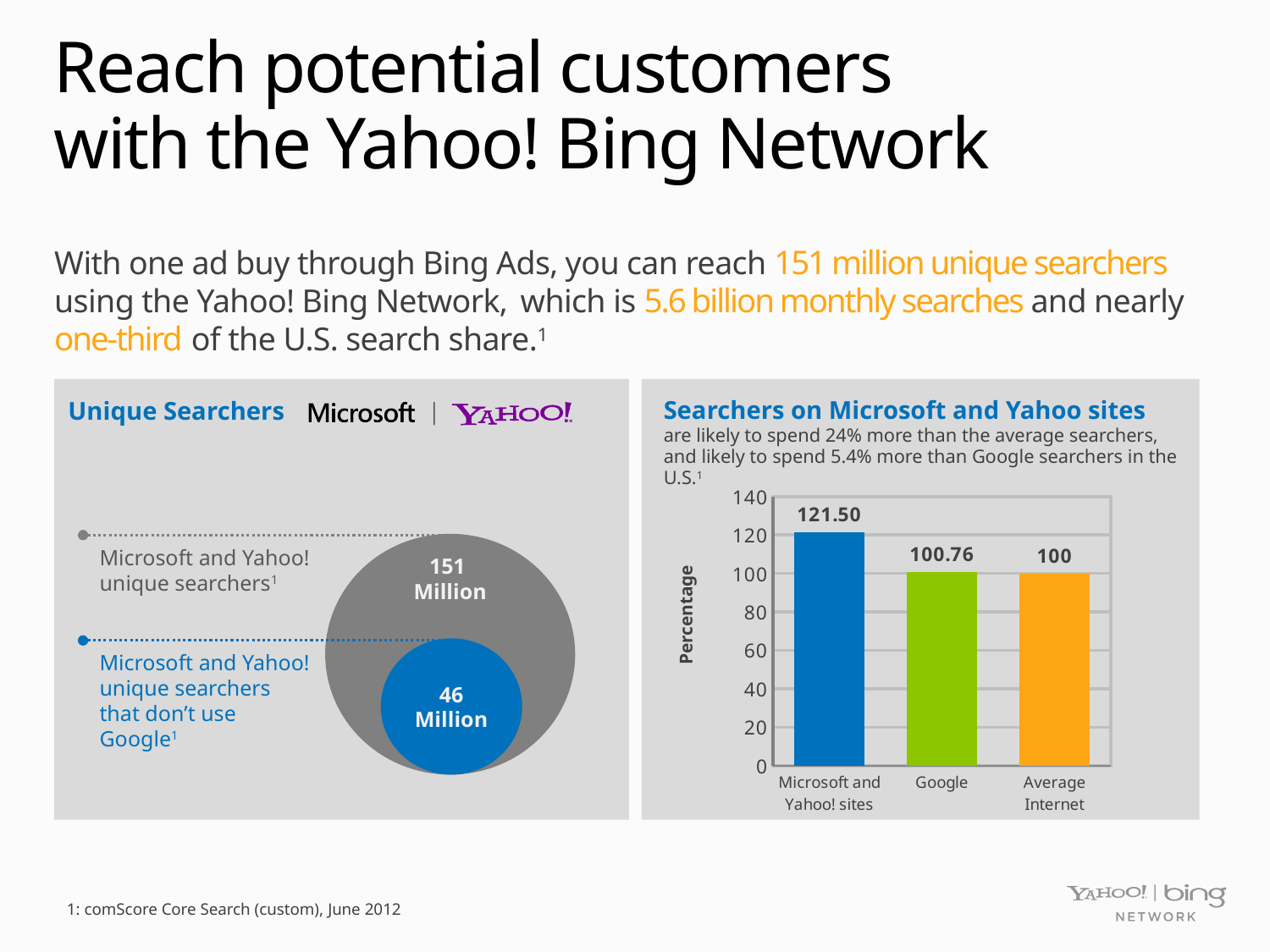
How many bars are shown in the bar chart on the right? 3 In the bar chart on the right, what is the value for Microsoft and Yahoo! sites? 121.50 In the bar chart on the right, which category has the lowest value? Average Internet In the bar chart on the right, what is the difference between the values for Google and Average Internet? 0.76 What is the label of the vertical axis in the bar chart on the right? Percentage In the bar chart on the right, what is the value for Google? 100.76 In the bar chart on the right, which is larger: the value for Microsoft and Yahoo! sites or the value for Average Internet? Microsoft and Yahoo! sites In the bar chart on the right, what is the value for Average Internet? 100 In the bar chart on the right, is the value for Microsoft and Yahoo! sites greater or less than 120? greater In the bar chart on the right, which category has the highest value? Microsoft and Yahoo! sites What type of chart is shown on the right side of the slide? bar chart In the bar chart on the right, what is the difference between the values for Microsoft and Yahoo! sites and Google? 20.74